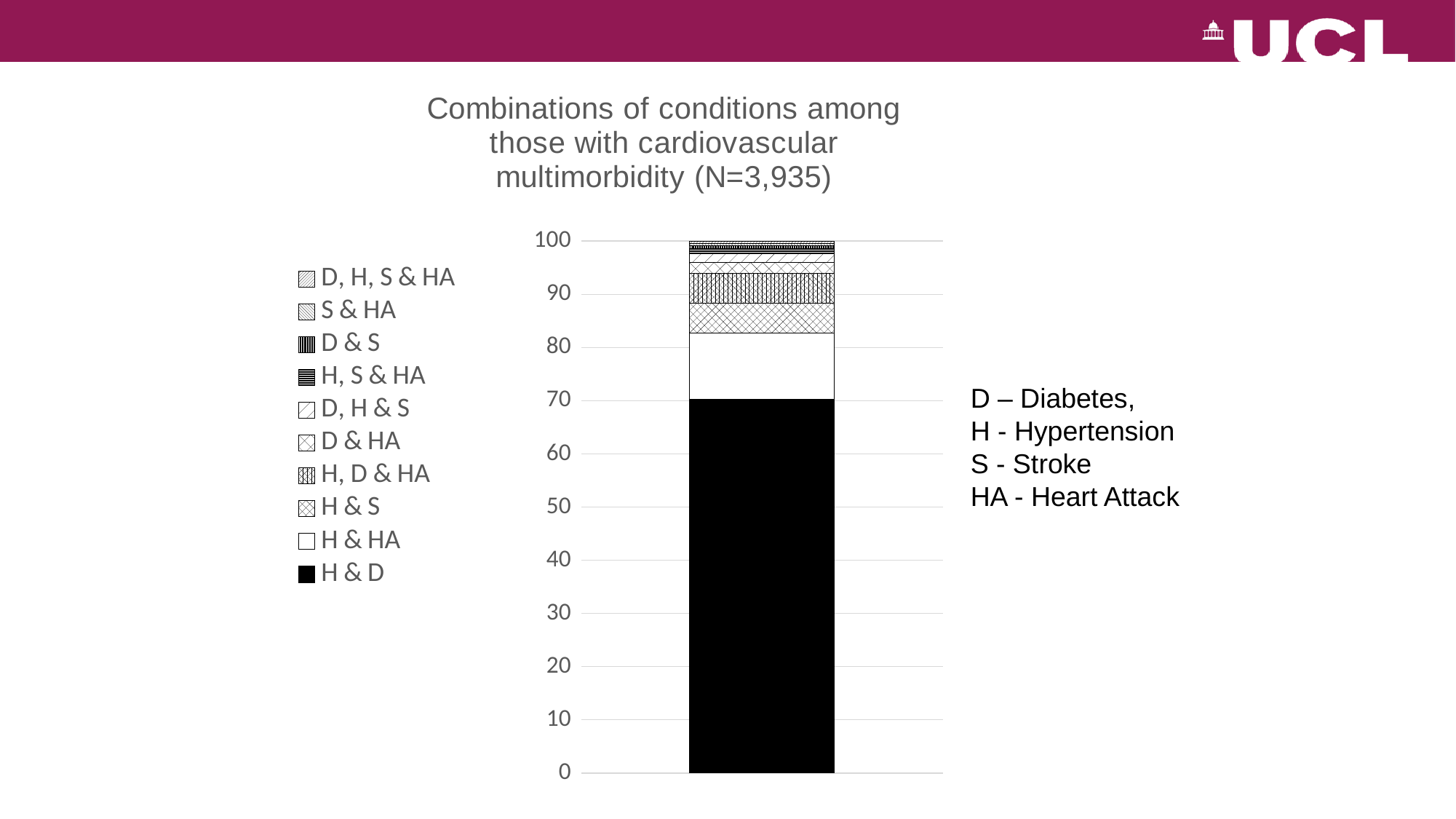
Which legend entry is shown with a solid black fill? H & D Which is larger, the segment for H & D or the segment for H & HA? H & D Is the value for H & D greater or less than 80? less How many series does the legend list? 10 What kind of chart is shown on the slide? stacked bar chart Which condition combination makes up the largest segment of the bar? H & D Which is larger, the segment for H & HA or the segment for H & S? H & HA What is the total height of the stacked bar? 100 How many bars are plotted in the chart? 1 What is the title of the chart? Combinations of conditions among those with cardiovascular multimorbidity (N=3,935) Is the value for H & D greater or less than 50? greater